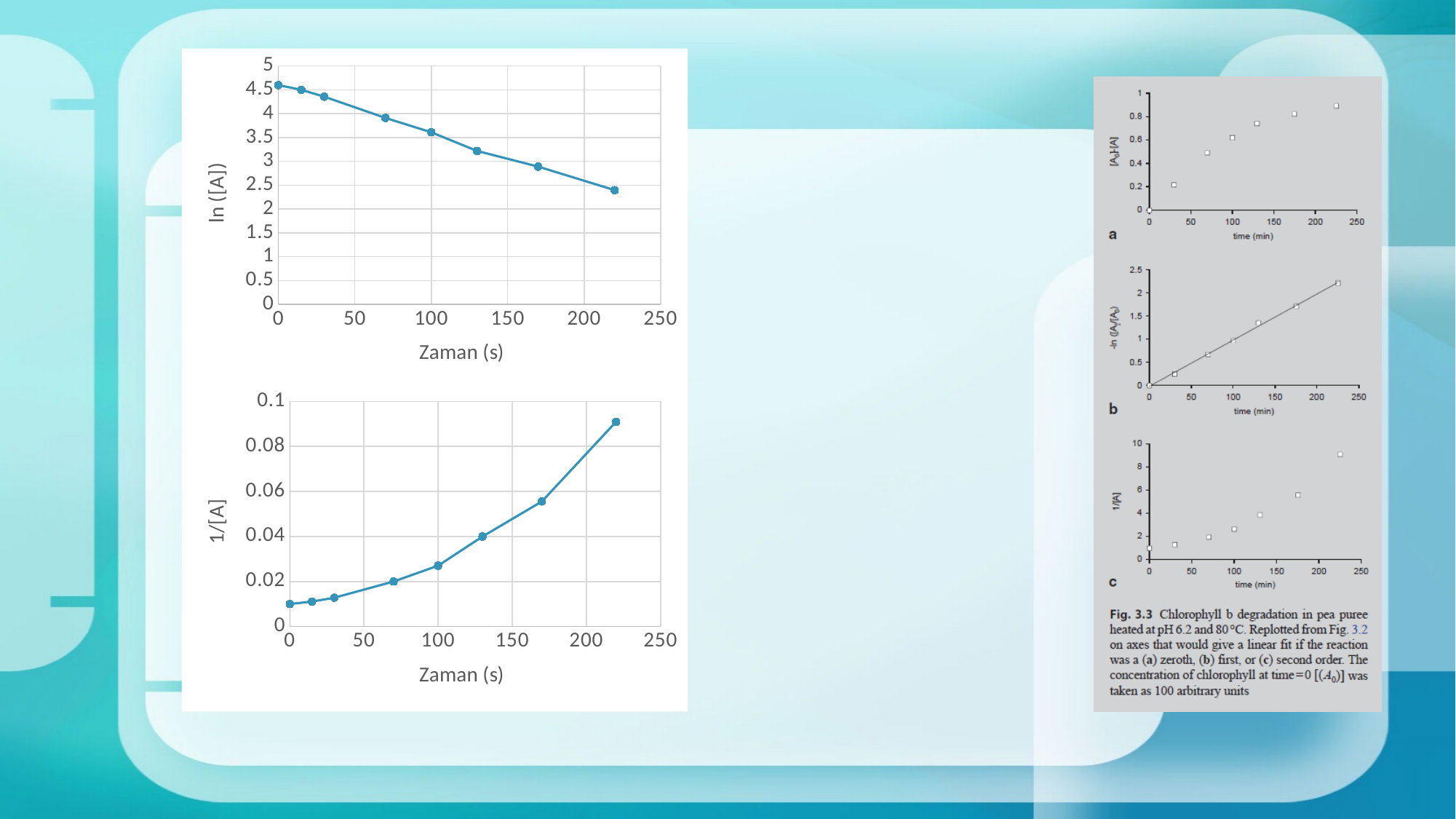
What is the x-axis title of the bottom-left chart? Zaman (s) In the bottom-left chart (1/[A] vs Zaman (s)), at which Zaman value is 1/[A] highest? 220 s In the top-left chart (ln ([A]) vs Zaman (s)), which is larger: the value at 0 s or the value at 220 s? 0 s In the bottom-left chart (1/[A] vs Zaman (s)), is the value at 220 s greater or less than 0.08? greater How many data points are plotted in the top-left chart (ln ([A]) vs Zaman (s))? 8 What kind of chart is the top-left chart with the y axis labelled ln ([A])? line chart How many data points are plotted in the bottom-left chart (1/[A] vs Zaman (s))? 8 In the top-left chart (ln ([A]) vs Zaman (s)), is the value at 220 s greater or less than 3? less In the top-left chart (ln ([A]) vs Zaman (s)), do the values rise or fall as Zaman increases? fall In the bottom-left chart (1/[A] vs Zaman (s)), is the value at 100 s greater or less than 0.02? greater In the bottom-left chart (1/[A] vs Zaman (s)), do the values rise or fall as Zaman increases? rise